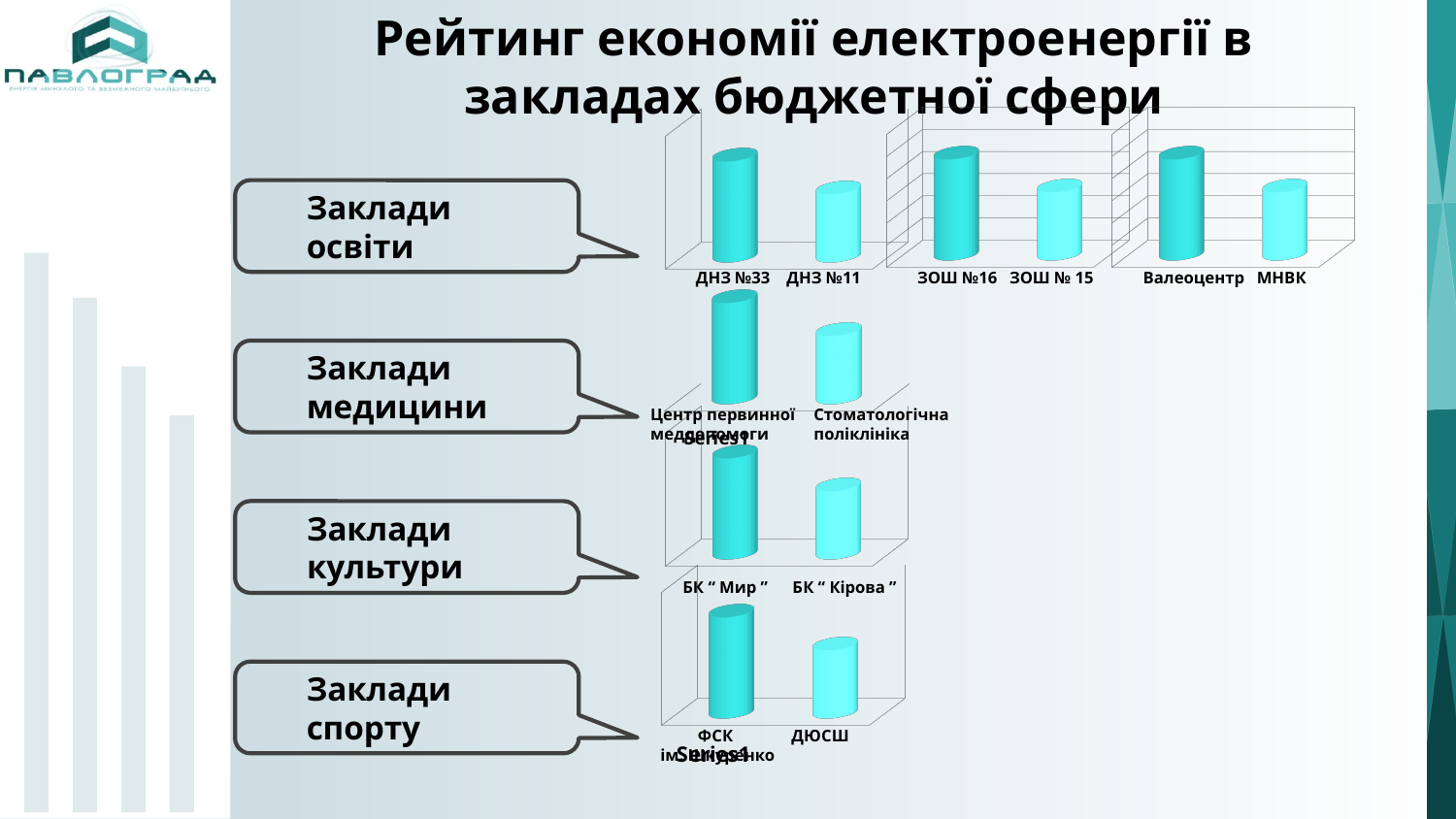
How many separate charts are shown in the top row next to 'Заклади освіти'? 3 What kind of chart is used next to 'Заклади медицини'? bar chart In the chart for Валеоцентр and МНВК (top right), which category has the lower value? МНВК In the chart next to 'Заклади культури', which category has the higher value, БК “Мир” or БК “Кірова”? БК “Мир” In the chart next to 'Заклади медицини', is the bar for Центр первинної меддопомоги taller or shorter than the bar for Стоматологічна поліклініка? taller In the chart next to 'Заклади спорту', which category has the lowest value? ДЮСШ What is the title of the slide containing these charts? Рейтинг економії електроенергії в закладах бюджетної сфери In the chart for ЗОШ №16 and ЗОШ № 15 (top middle), which category has the higher value? ЗОШ №16 How many categories are shown in the chart next to 'Заклади культури'? 2 In the chart for ДНЗ №33 and ДНЗ №11 (top left), which of the two has the taller bar? ДНЗ №33 How many categories are shown in the chart for Валеоцентр and МНВК (top right)? 2